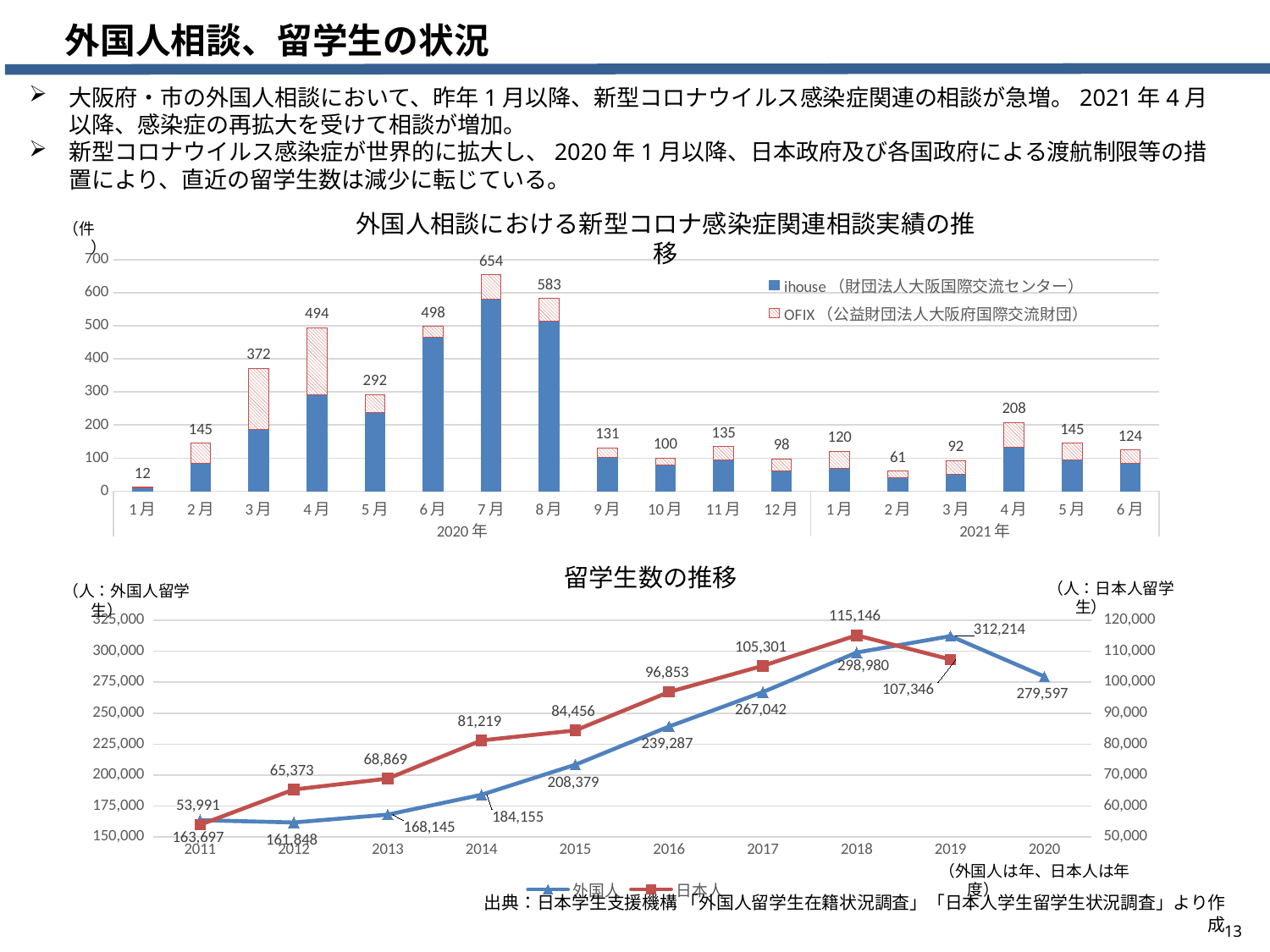
In the top chart, what is the difference between the totals for 4月 2021 and 3月 2021? 116 In the bottom chart (留学生数の推移), what is the value for 外国人 in 2019? 312,214 In the bottom chart, what is the difference between the 外国人 values for 2019 and 2020? 32,617 In the top chart (外国人相談における新型コロナ感染症関連相談実績の推移), what is the total number of consultations labeled for 7月 2020? 654 In the top chart, which month has the lowest total number of consultations? 1月 2020 In the top chart, which month has the highest total number of consultations? 7月 2020 In the top chart, what kind of chart is used? Stacked bar chart In the bottom chart, which year has the highest value for 日本人? 2018 In the top chart, is the total for 8月 2020 greater or less than 500? greater In the bottom chart, what is the value for 日本人 in 2018? 115,146 In the top chart, how many series does the legend list? 2 In the bottom chart, how many data points are plotted for the 外国人 series? 10